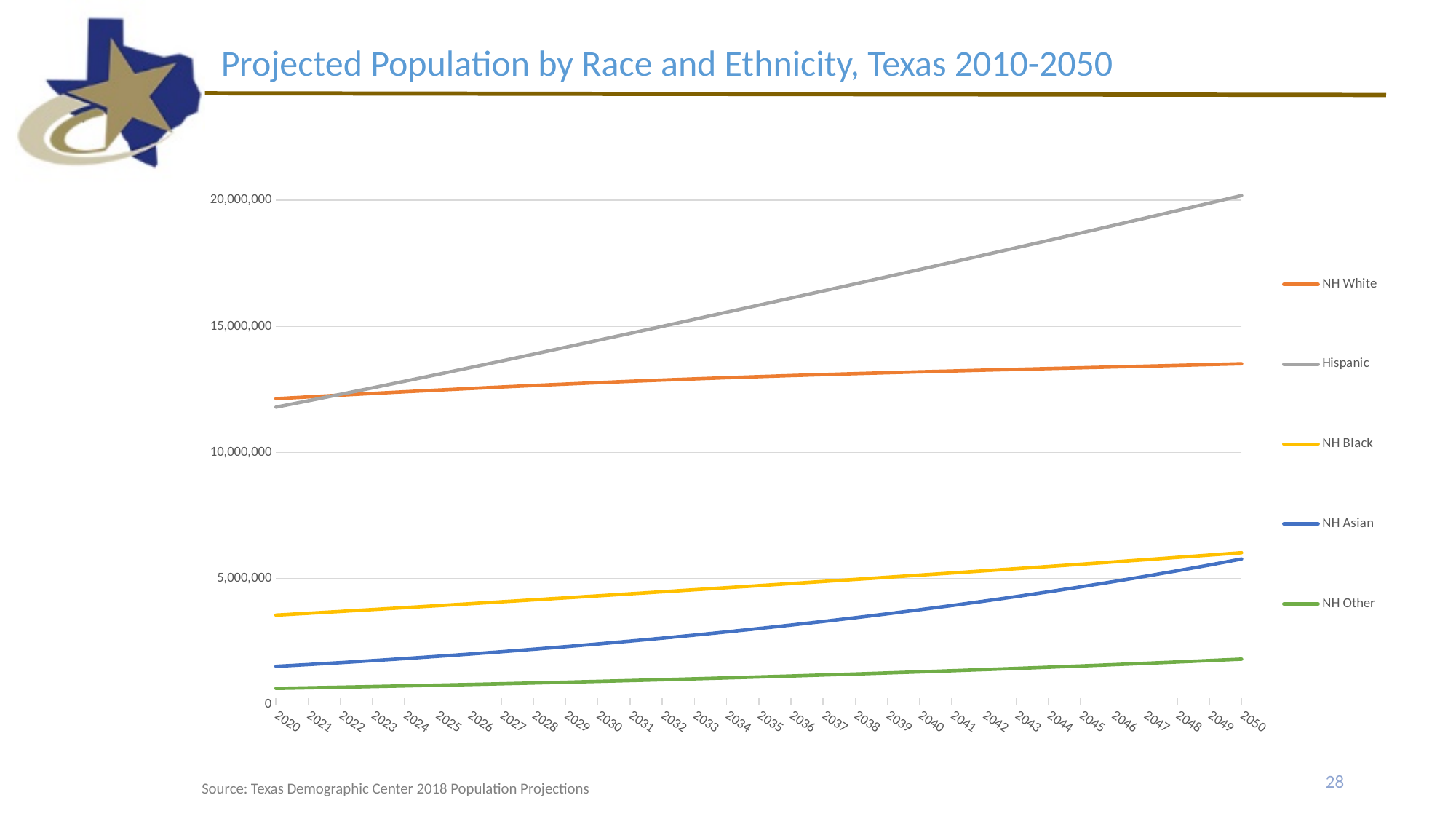
Is the NH Other value in 2050 greater or less than 5,000,000? less Is the NH Asian value in 2050 greater or less than 5,000,000? greater Is the Hispanic value in 2050 greater or less than 15,000,000? greater In 2020, which is larger: NH Black or NH Asian? NH Black What is the title of the chart? Projected Population by Race and Ethnicity, Texas 2010-2050 Which series has the highest projected population in 2050? Hispanic How many years are shown along the x axis? 31 How many series does the legend list? 5 Which series has the lowest projected population in 2050? NH Other Does the Hispanic line rise or fall from 2020 to 2050? Rise What kind of chart is shown on the slide? Line chart